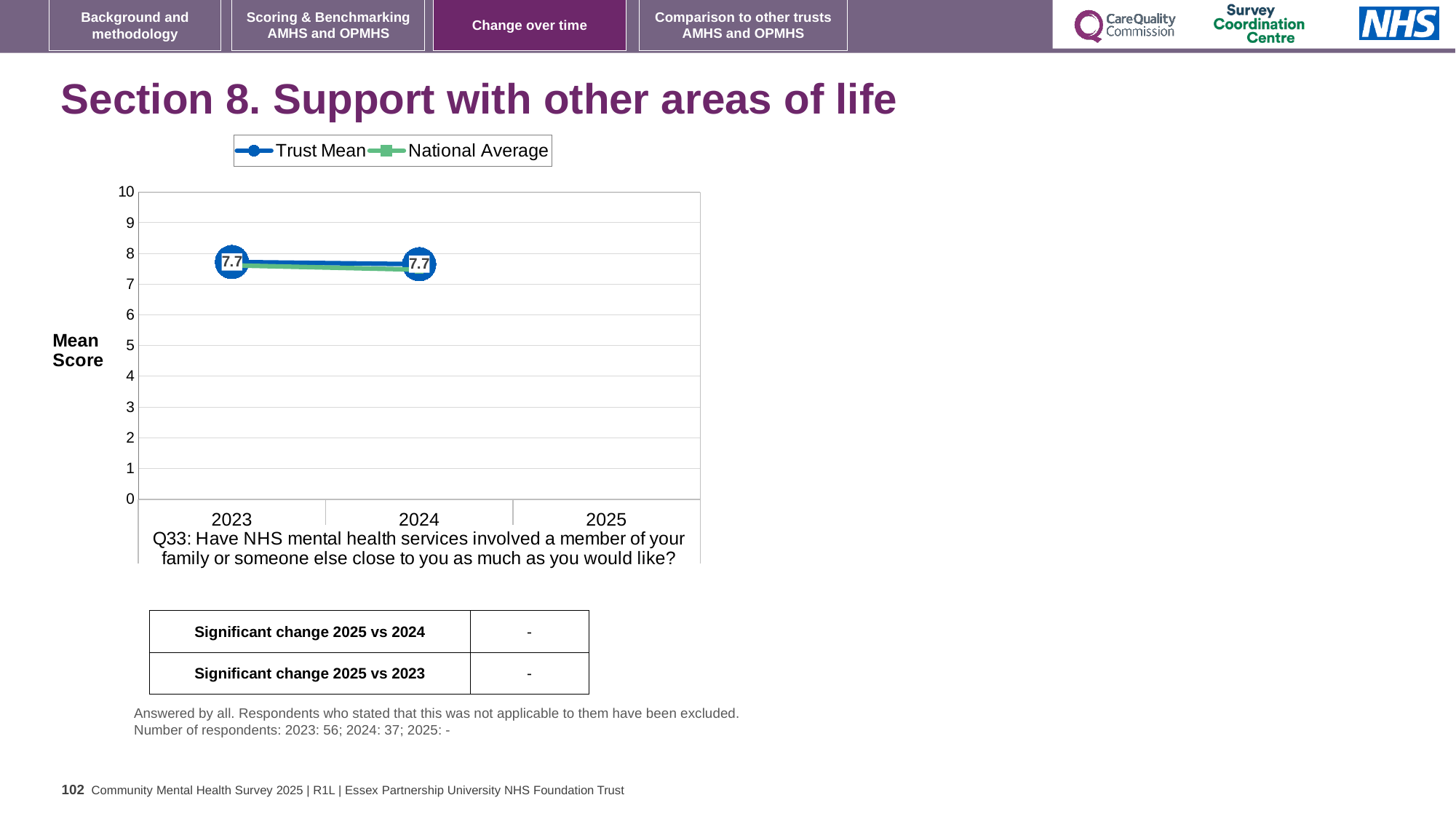
What is the highest value shown on the y axis? 10 What kind of chart is shown on the slide? Line chart Is the National Average value for 2024 greater or less than 5? greater Does the Trust Mean rise, fall or stay the same from 2023 to 2024? Stays the same Which year on the x axis has no plotted data? 2025 What is the Trust Mean value for 2023? 7.7 What is the label on the y axis? Mean Score Is the Trust Mean value for 2023 greater or less than 8? less How many years are shown on the x axis? 3 How many series does the legend list? 2 What is the difference between the Trust Mean in 2024 and the Trust Mean in 2023? 0 What is the Trust Mean value for 2024? 7.7